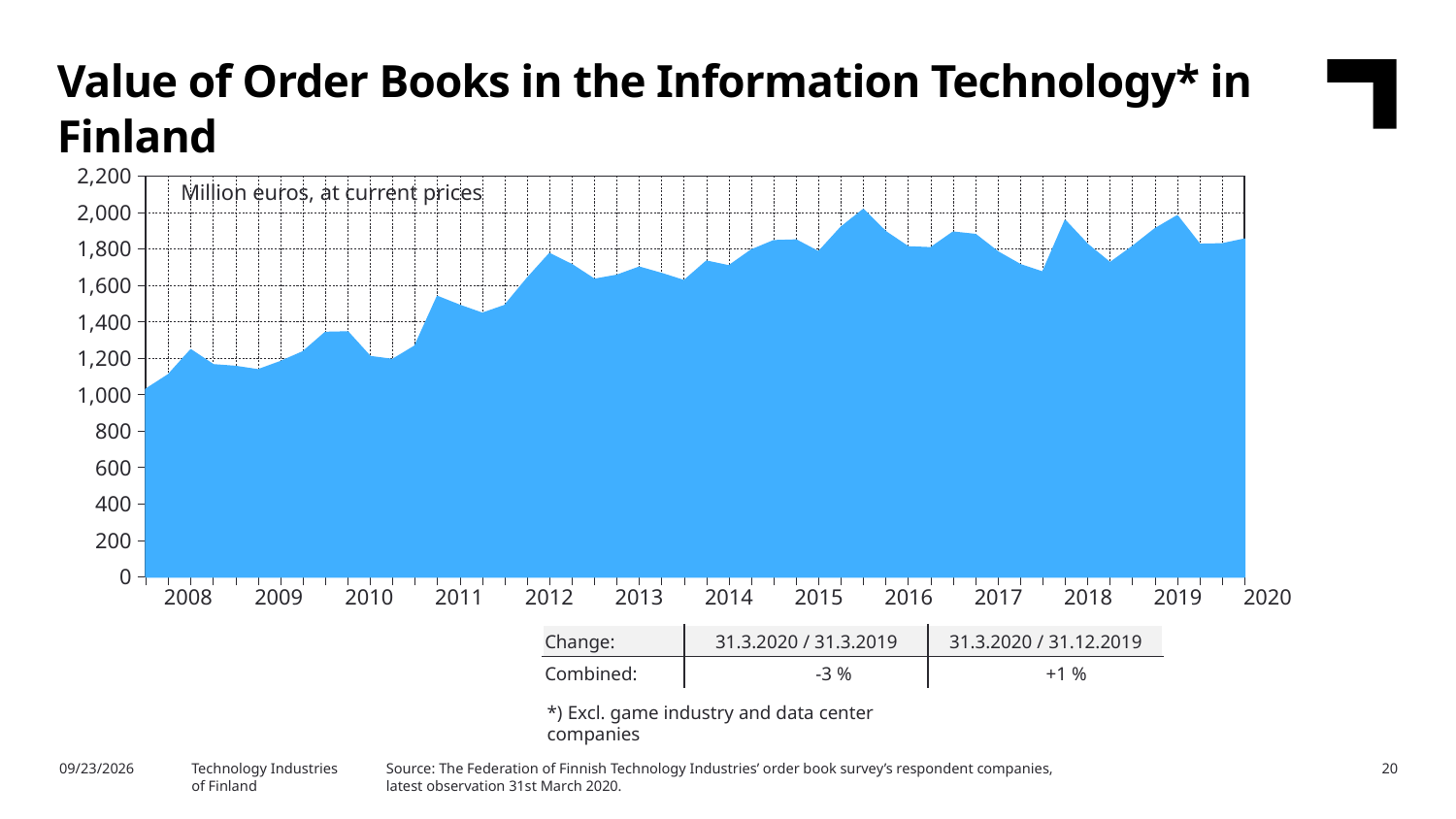
Is the value at the start of 2010 greater or less than 1,400? less Is the value at the start of 2020 greater or less than 1,600? greater What unit is the chart measured in, according to the label inside the plot area? Million euros, at current prices What kind of chart is shown on the slide? area chart How many year labels are shown on the x axis? 13 Is the value at the start of 2012 greater or less than 1,600? greater Overall, do the values rise or fall from 2008 to 2020? rise Which is larger, the value at the start of 2008 or the value at the start of 2020? 2020 In which year does the chart show its lowest value? 2008 What is the title of the chart on the slide? Value of Order Books in the Information Technology* in Finland